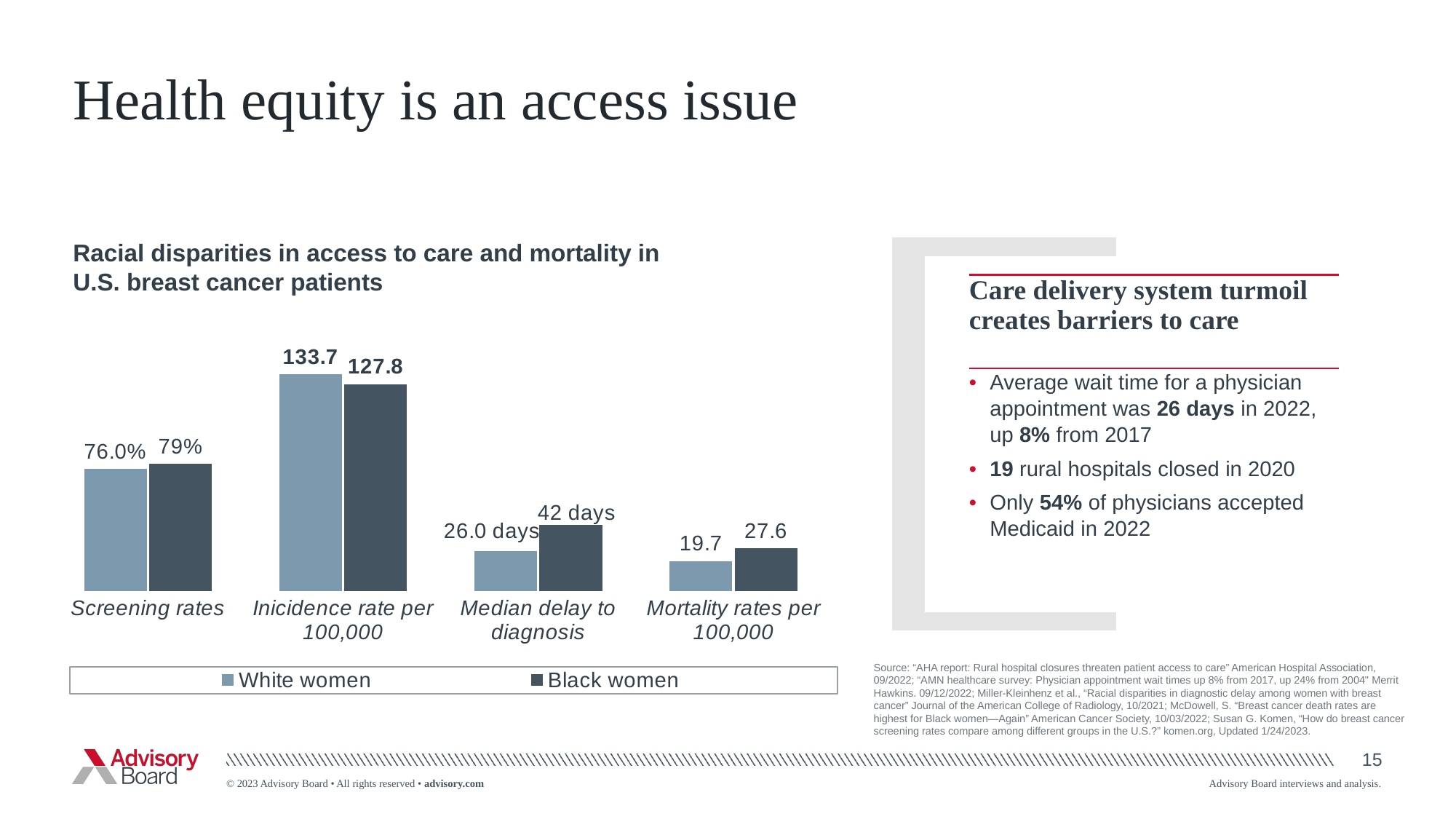
How many categories are shown on the x axis of the chart? 4 How many series does the chart legend list? 2 For Inicidence rate per 100,000, which series has the larger value, White women or Black women? White women What is the difference between the Black women and White women values for Mortality rates per 100,000? 7.9 What is the difference between the Black women and White women values for Median delay to diagnosis? 16 days What is the value for White women for Inicidence rate per 100,000? 133.7 What is the value for Black women for Median delay to diagnosis? 42 days What is the value for White women for Screening rates? 76.0% What kind of chart is shown on the slide? Bar chart What is the value for Black women for Mortality rates per 100,000? 27.6 What is the value for Black women for Screening rates? 79% What is the difference between the White women and Black women values for Inicidence rate per 100,000? 5.9